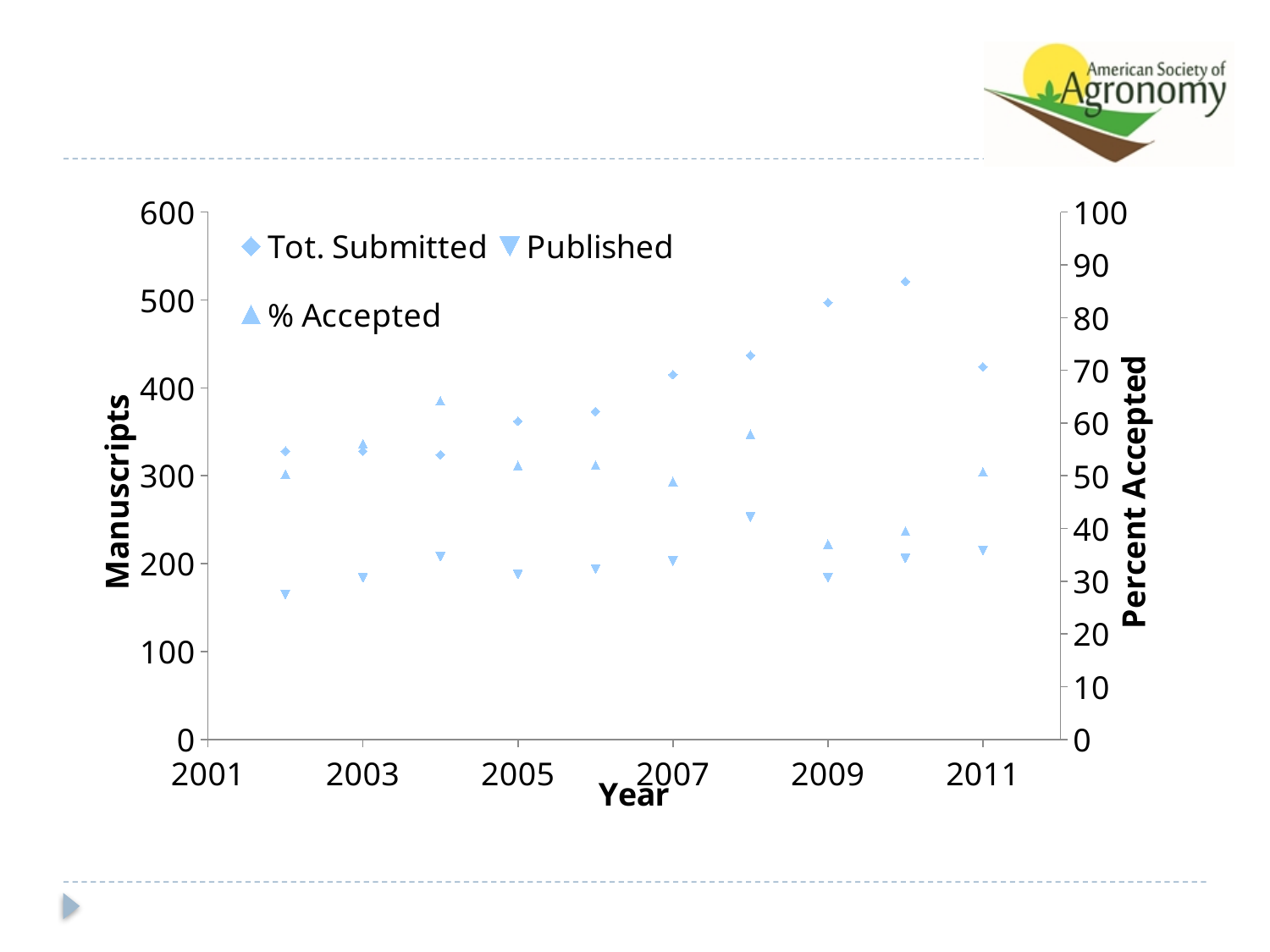
What is the title of the right-hand vertical axis? Percent Accepted Is the Tot. Submitted value for 2010 greater or less than 500? greater In which year is the Tot. Submitted value highest? 2010 How many series does the legend list? 3 In which year is the Published value highest? 2008 In which year is the % Accepted value highest? 2004 In which year is the Published value lowest? 2002 What kind of chart is shown on the slide? scatter chart How many years are plotted for the Tot. Submitted series? 10 Which year has the larger Tot. Submitted value, 2009 or 2011? 2009 Is the Published value for 2002 greater or less than 200? less Is the % Accepted value for 2009 greater or less than 50? less